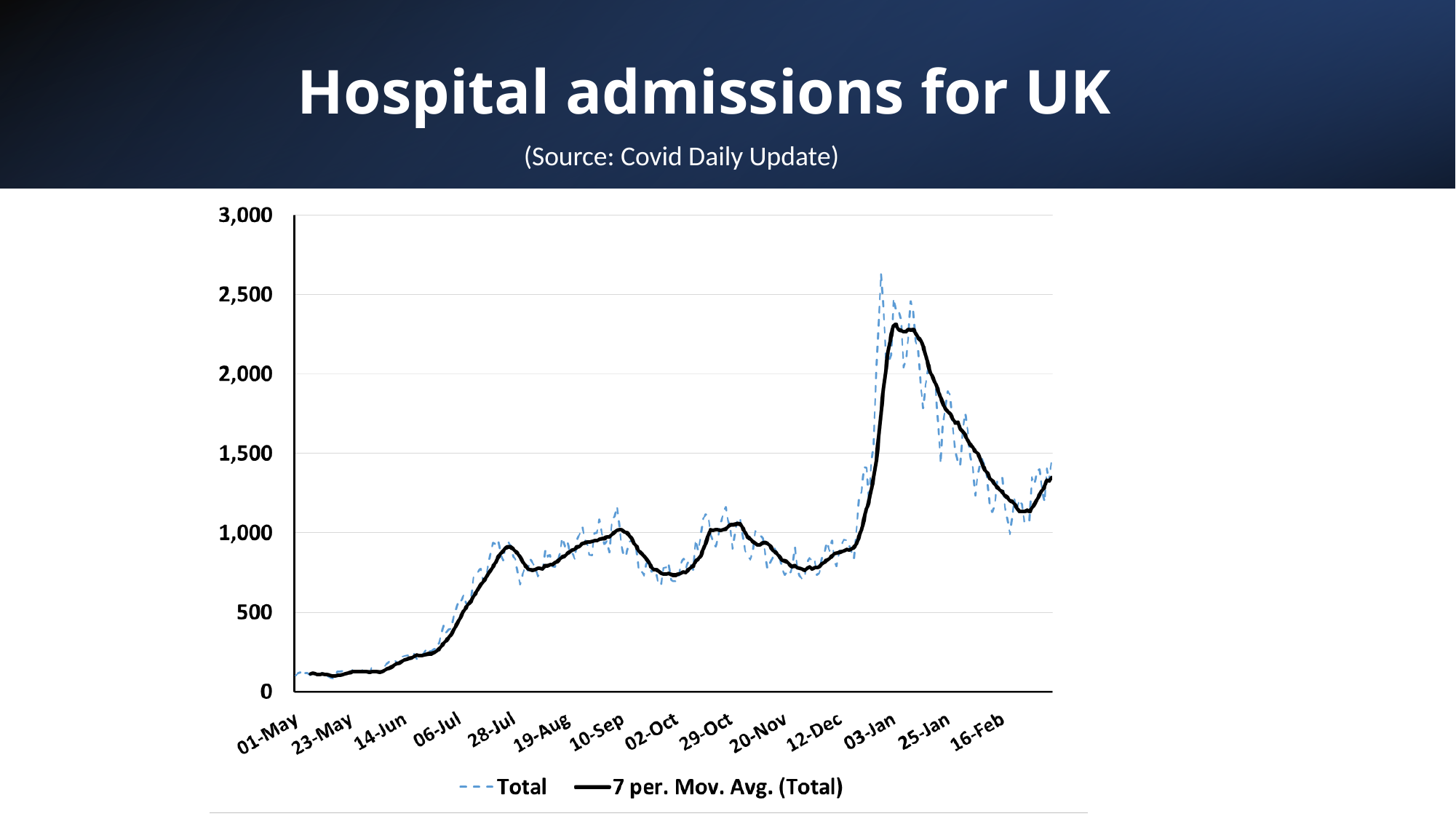
How many date labels are shown on the x axis? 14 How many series does the legend list? 2 Around which x-axis date label does the Total line reach its highest point? 03-Jan Does the 7 per. Mov. Avg. (Total) line rise or fall between 25-Jan and 16-Feb? Fall Is the value of the 7 per. Mov. Avg. (Total) line at 28-Jul greater or less than 500? greater Which series is drawn as a dashed line? Total Is the peak value of the 7 per. Mov. Avg. (Total) line greater or less than 2,000? greater What kind of chart is shown on the slide? Line chart Is the value of the 7 per. Mov. Avg. (Total) line at 01-May greater or less than 500? less What are the two series named in the legend? Total and 7 per. Mov. Avg. (Total) Does the 7 per. Mov. Avg. (Total) line rise or fall between 01-May and 06-Jul? Rise Which is larger for the 7 per. Mov. Avg. (Total) line: the value at 16-Feb or the value at 01-May? 16-Feb